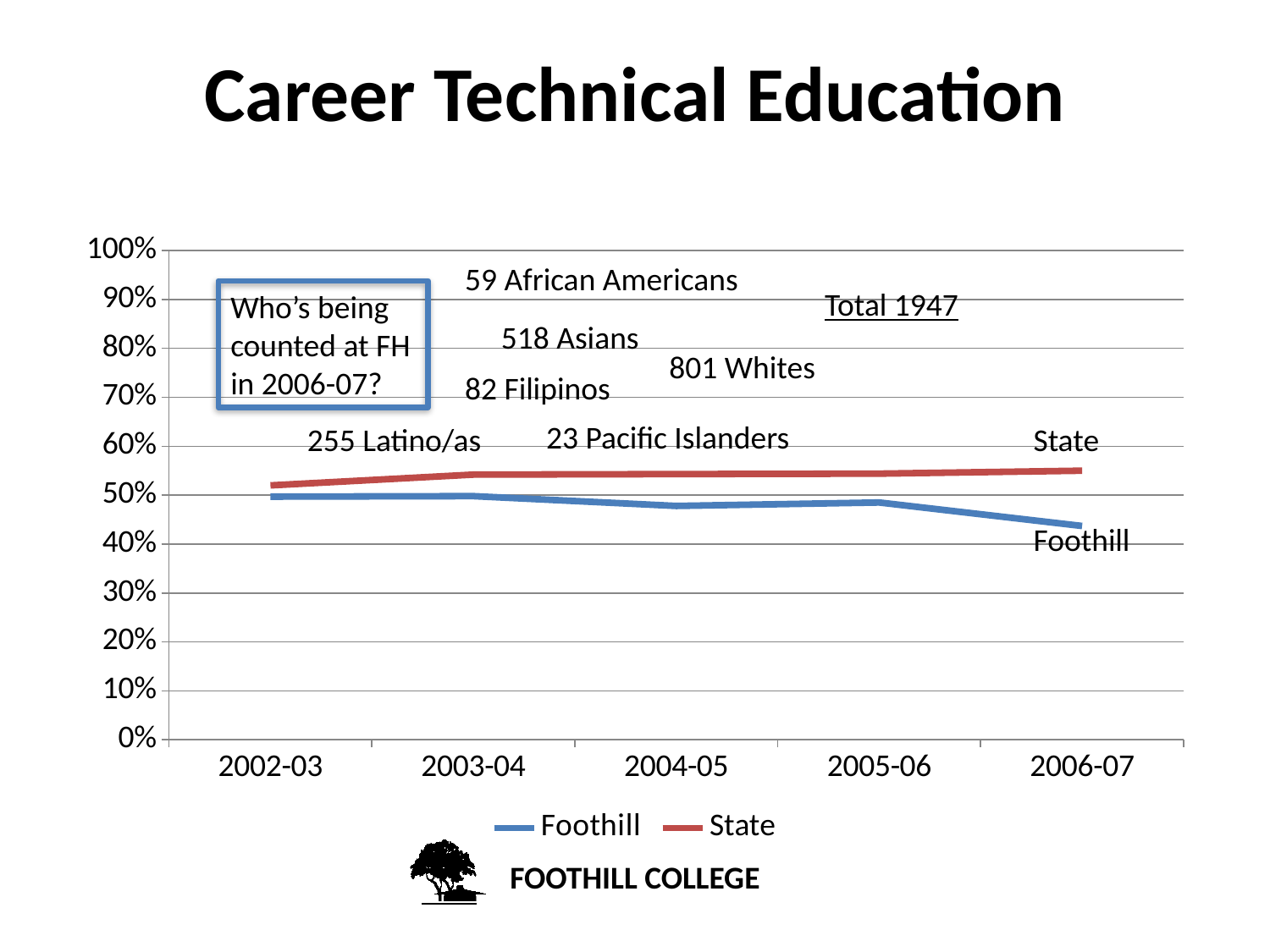
Is the Foothill value for 2004-05 greater or less than 50%? less Is the State value for 2006-07 greater or less than 50%? greater Is the Foothill value for 2006-07 greater or less than 50%? less What are the two entries in the chart legend? Foothill, State What colour is the State line in the chart? red Does the Foothill series rise or fall from 2005-06 to 2006-07? fall In which year is the Foothill series at its lowest? 2006-07 Which series is higher in 2006-07, Foothill or State? State How many academic years are shown on the x axis of the chart? 5 How many series does the chart legend list? 2 What kind of chart is shown on the slide? line chart